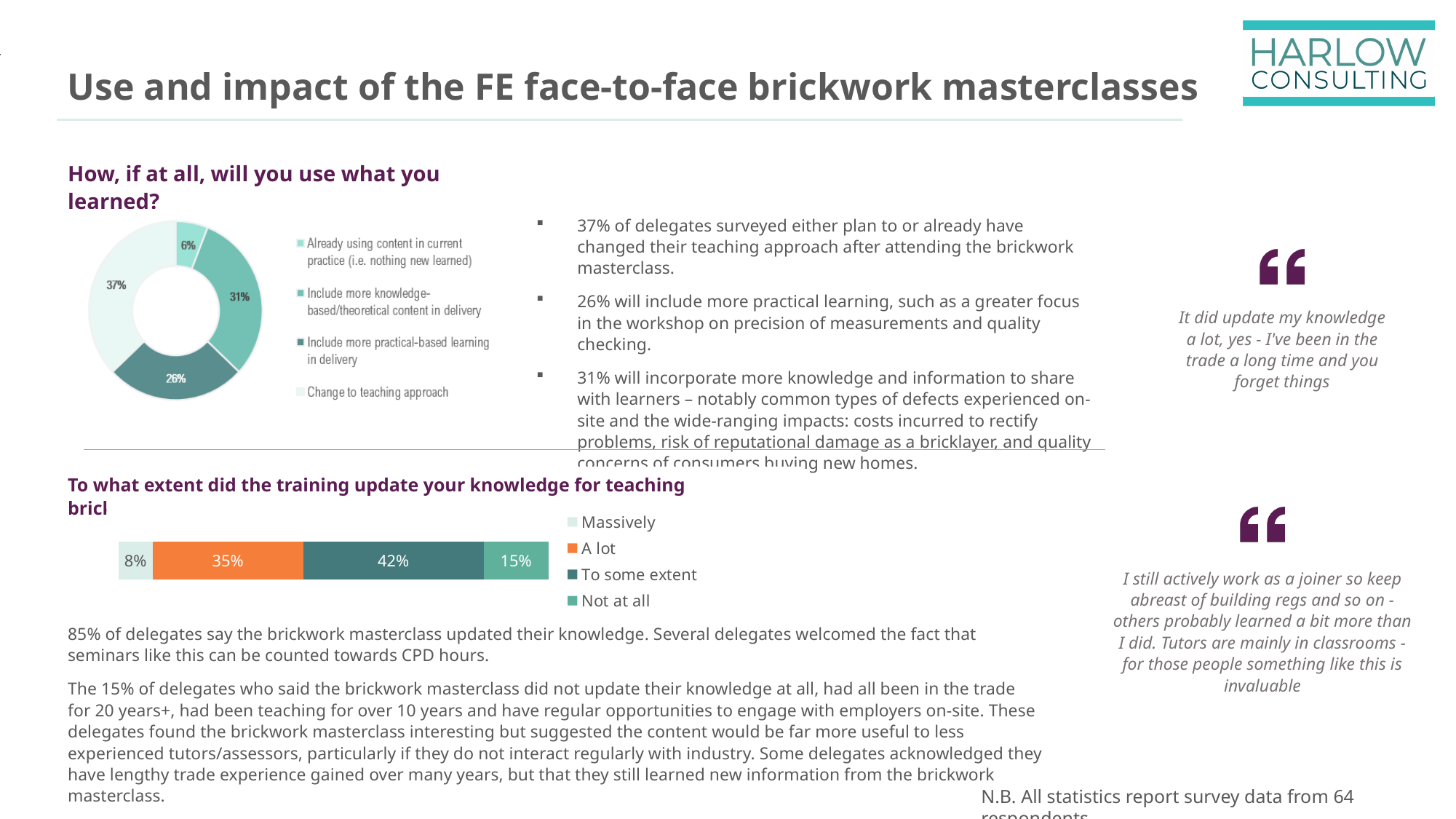
In the donut chart 'How, if at all, will you use what you learned?', which category has the smallest share? Already using content in current practice (i.e. nothing new learned) In the donut chart 'How, if at all, will you use what you learned?', what is the difference in percentage points between 'Include more knowledge-based/theoretical content in delivery' and 'Include more practical-based learning in delivery'? 5 percentage points How many categories does the donut chart 'How, if at all, will you use what you learned?' show? 4 In the donut chart 'How, if at all, will you use what you learned?', which category has the largest share? Change to teaching approach In the stacked bar chart 'To what extent did the training update your knowledge for teaching brickwork', what percentage answered 'Massively'? 8% What type of chart is used for 'How, if at all, will you use what you learned?'? Donut (pie) chart In the donut chart 'How, if at all, will you use what you learned?', what percentage said they are already using the content in current practice? 6% In the stacked bar chart 'To what extent did the training update your knowledge for teaching brickwork', what is the combined percentage of 'Massively', 'A lot' and 'To some extent'? 85% How many response categories does the legend of the stacked bar chart 'To what extent did the training update your knowledge for teaching brickwork' list? 4 In the stacked bar chart 'To what extent did the training update your knowledge for teaching brickwork', what percentage answered 'To some extent'? 42% In the donut chart 'How, if at all, will you use what you learned?', what percentage of delegates said they will change their teaching approach? 37% In the stacked bar chart 'To what extent did the training update your knowledge for teaching brickwork', which is larger: 'A lot' or 'Not at all'? A lot